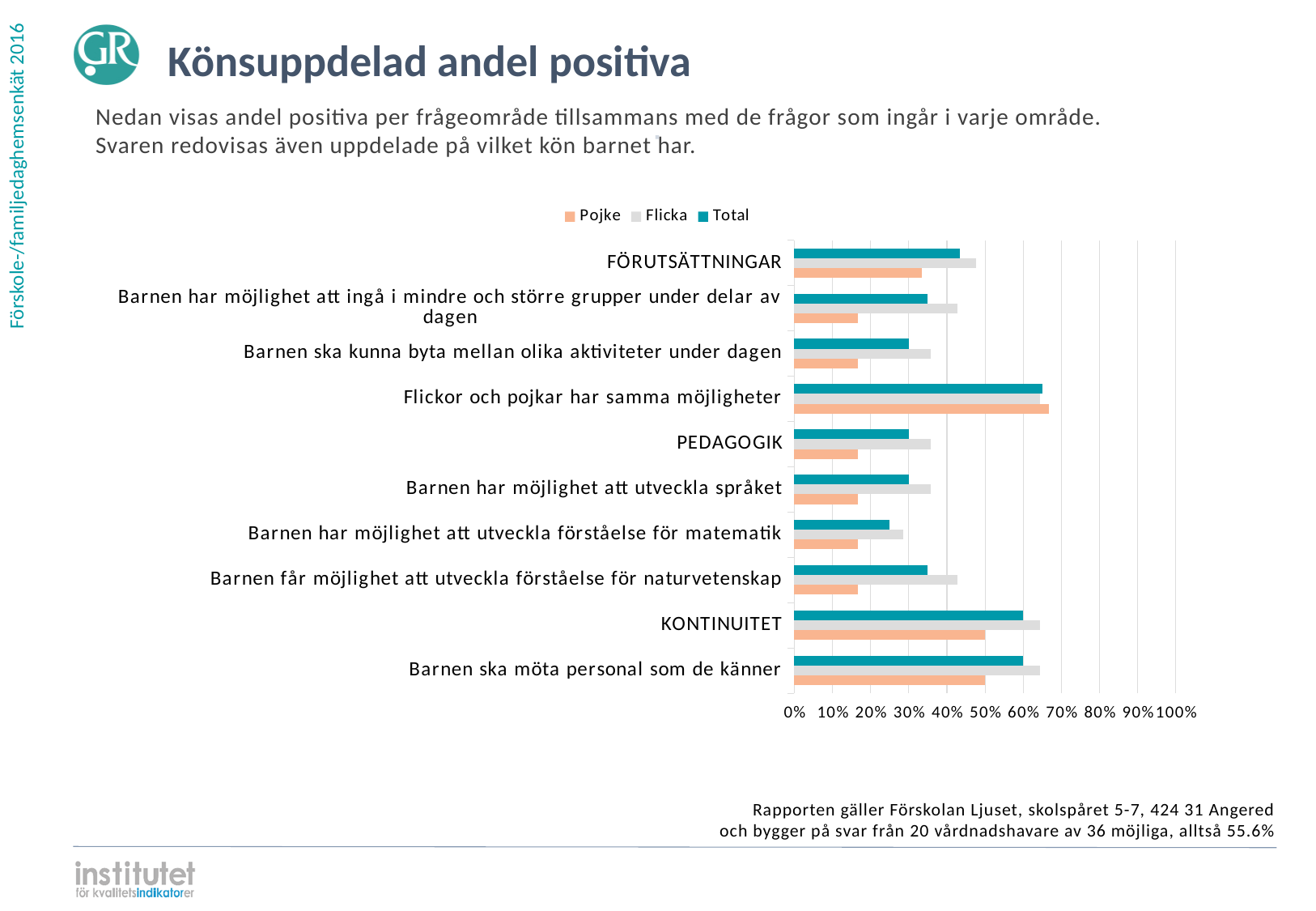
Is the Pojke value for KONTINUITET greater or less than 40%? greater What are the series names listed in the legend? Pojke, Flicka, Total What kind of chart is shown on the slide? Bar chart What is the title of the chart slide? Könsuppdelad andel positiva Is the Total value for Barnen har möjlighet att utveckla förståelse för matematik greater or less than 30%? less For FÖRUTSÄTTNINGAR, which is larger: the Flicka value or the Pojke value? Flicka Is the Flicka value for Barnen ska möta personal som de känner greater or less than 60%? greater How many series does the legend list? 3 Which category has the highest Total value? Flickor och pojkar har samma möjligheter Which category has the lowest Total value? Barnen har möjlighet att utveckla förståelse för matematik How many categories are shown on the vertical axis of the chart? 10